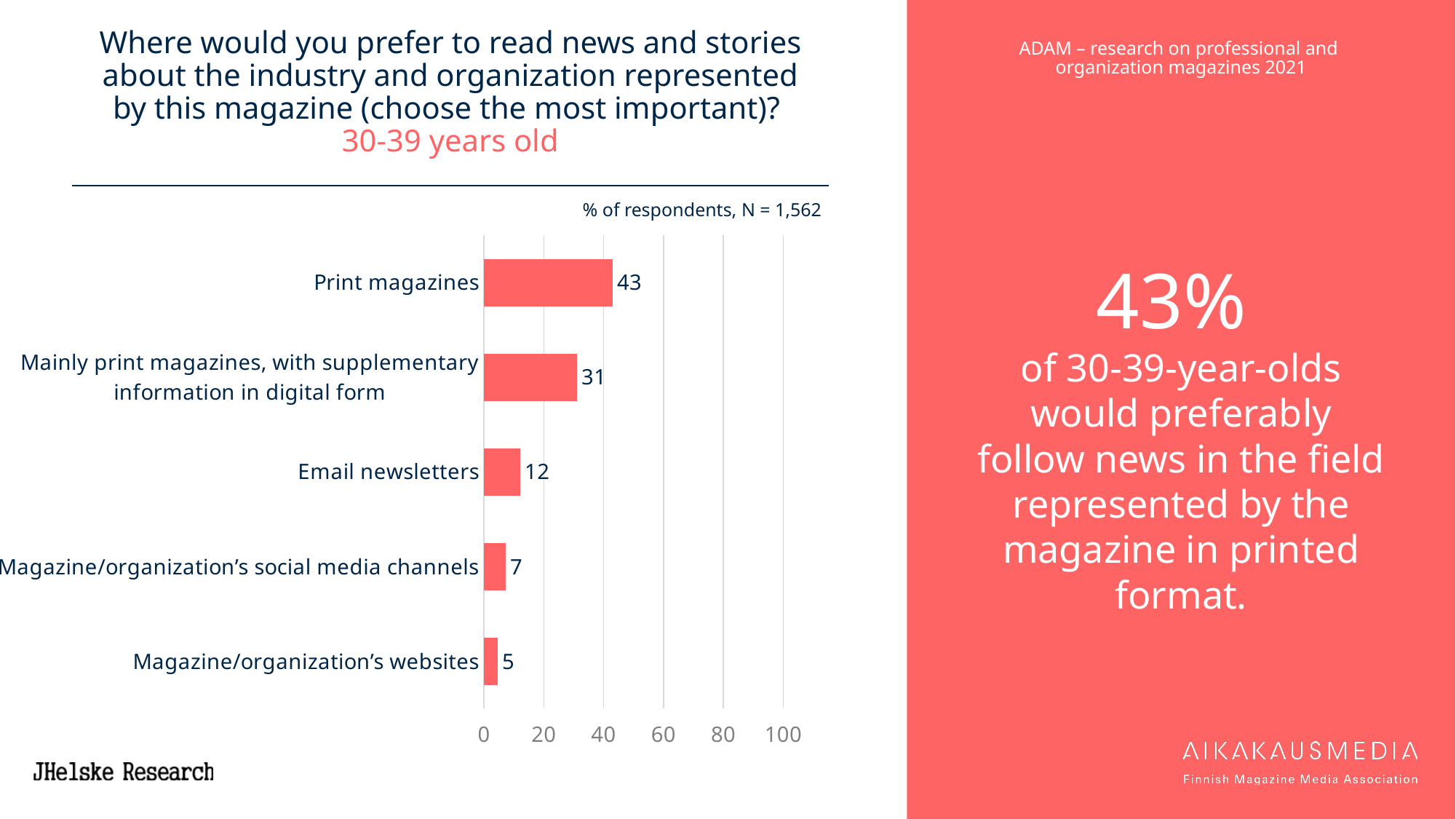
Which is larger: the value for magazine/organization's social media channels or for email newsletters? Email newsletters What percentage of 30-39-year-old respondents prefer print magazines? 43 Which category has the lowest value? Magazine/organization's websites What is the value for 'Mainly print magazines, with supplementary information in digital form'? 31 Which category has the highest value? Print magazines What is the difference between the values for print magazines and email newsletters? 31 What is the sample size (N) stated above the chart? 1,562 What is the value for email newsletters? 12 What kind of chart is shown on the slide? Bar chart What is the value for magazine/organization's websites? 5 Is the value for print magazines greater or less than 40? greater How many categories are shown in the chart? 5